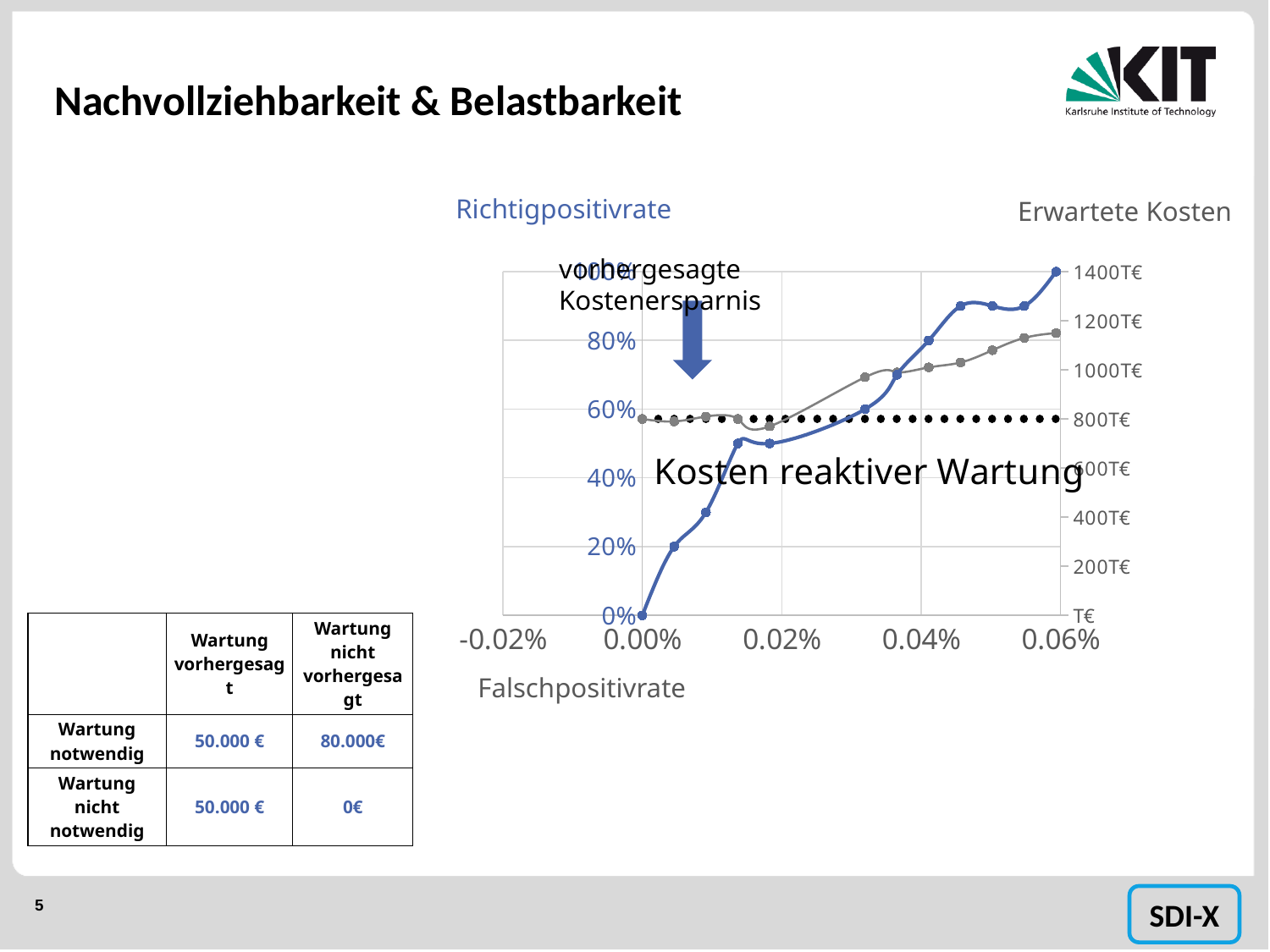
Is the Richtigpositivrate at a Falschpositivrate of 0.02% greater or less than 60%? less At a Falschpositivrate of 0.04%, which is larger: the Erwartete Kosten or the Kosten reaktiver Wartung? Erwartete Kosten What kind of chart is shown on the slide? line chart What is the title of the right-hand vertical axis of the chart? Erwartete Kosten What is the Richtigpositivrate at a Falschpositivrate of 0.06%? 100% What is the label of the x axis of the chart? Falschpositivrate Is the Richtigpositivrate at a Falschpositivrate of 0.04% greater or less than 60%? greater What is the Richtigpositivrate at a Falschpositivrate of 0.00%? 0% Does the Richtigpositivrate rise or fall as the Falschpositivrate increases from 0.00% to 0.06%? rise At what constant value does the dotted Kosten reaktiver Wartung line sit? 800T€ Are the Erwartete Kosten at a Falschpositivrate of 0.00% greater or less than 1000T€? less